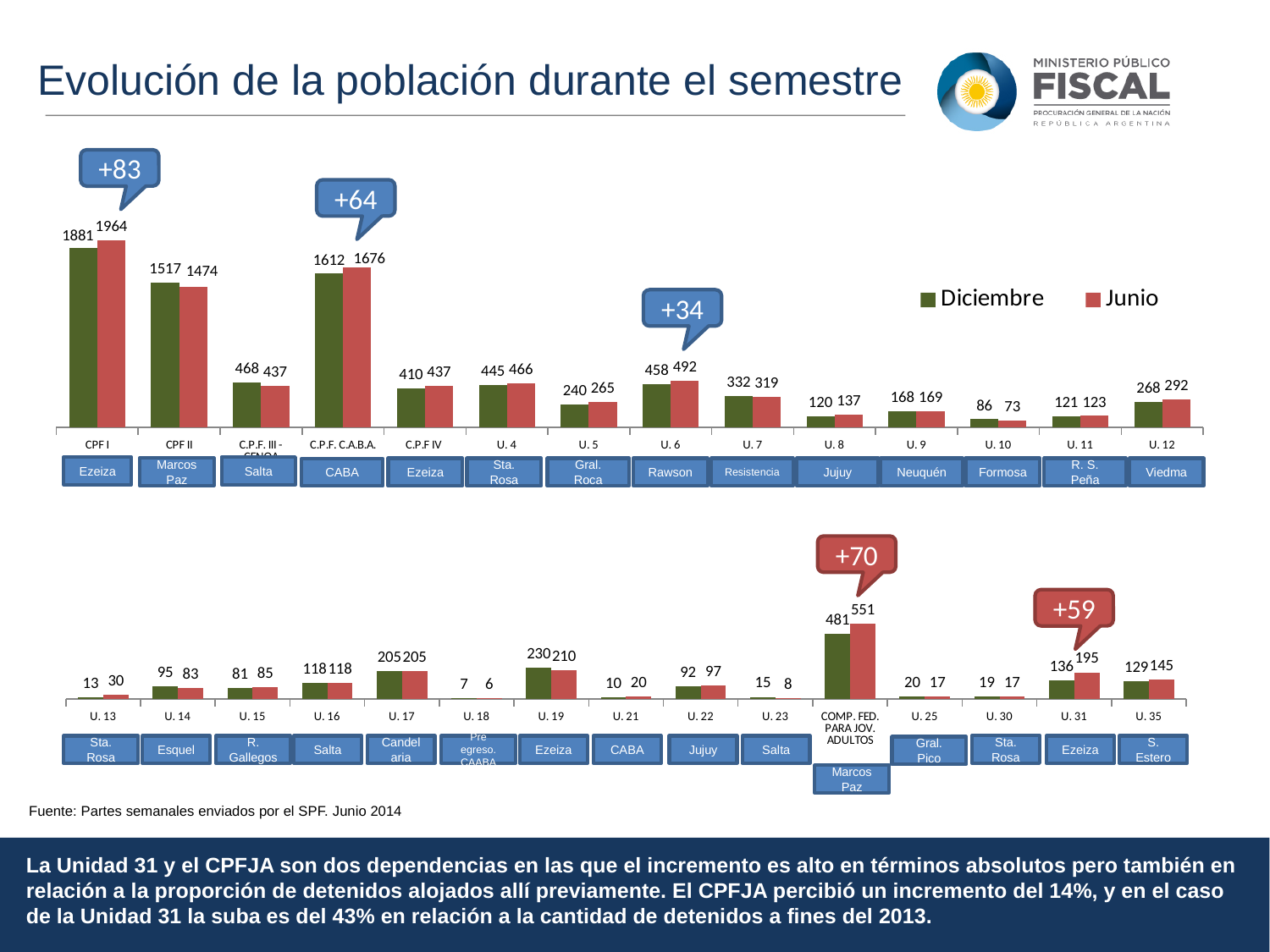
In the top chart, which is larger for CPF II: the Diciembre value or the Junio value? Diciembre In the top chart, what is the difference between the Junio and Diciembre values for C.P.F. C.A.B.A.? 64 In the bottom chart, what is the Junio value for U. 31? 195 What type of chart is the top chart? Bar chart In the top chart, which category has the lowest Diciembre value? U. 10 In the top chart, what is the Junio value for CPF I? 1964 In the bottom chart, which category has the highest Junio value? COMP. FED. PARA JOV. ADULTOS How many series does the legend list? 2 In the top chart, which category has the highest Junio value? CPF I In the bottom chart, what is the difference between the Junio and Diciembre values for U. 13? 17 In the top chart, what is the Diciembre value for U. 7? 332 In the bottom chart, what is the Diciembre value for COMP. FED. PARA JOV. ADULTOS? 481